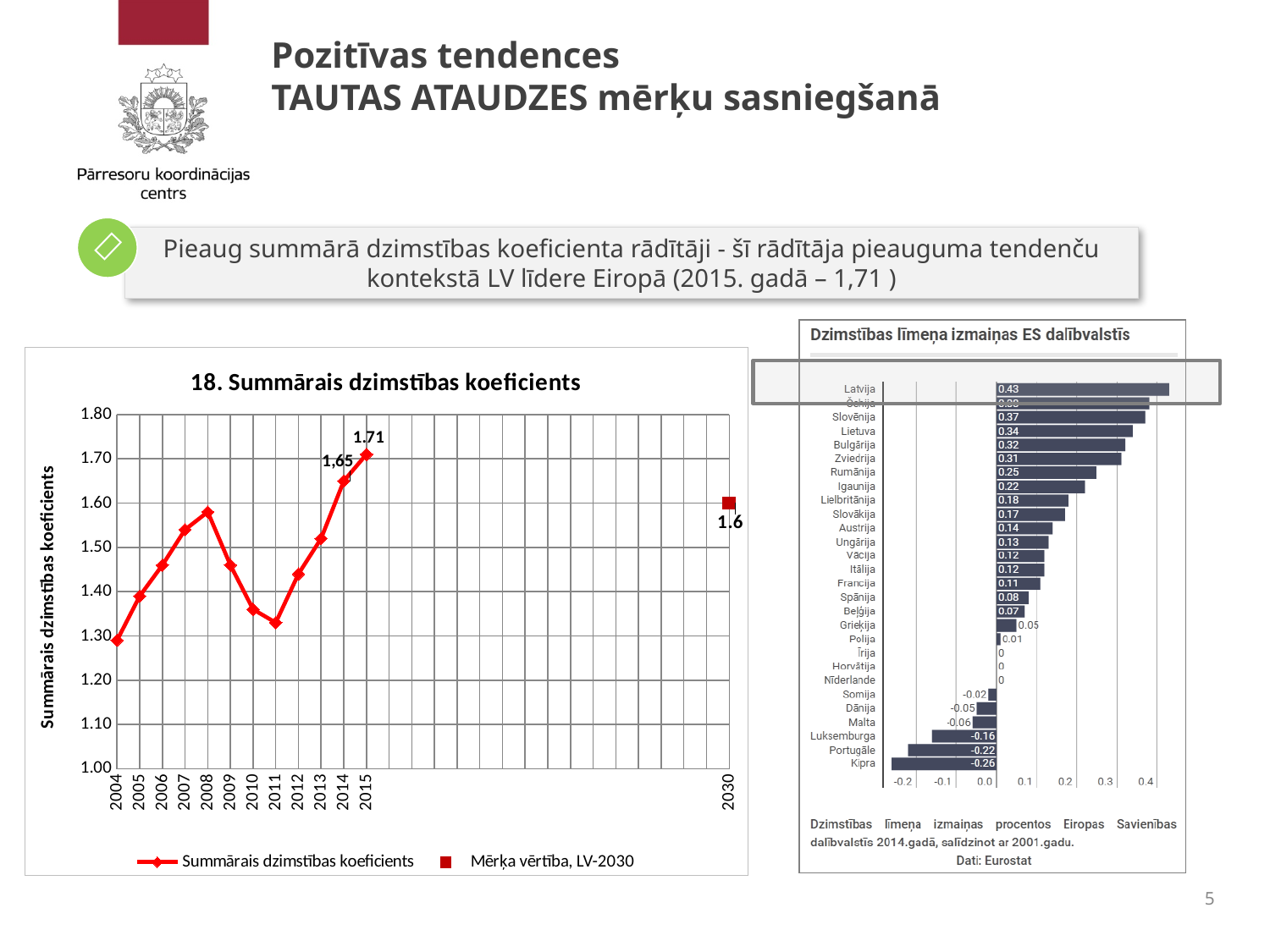
What kind of chart is '18. Summārais dzimstības koeficients'? line chart In the chart 'Dzimstības līmeņa izmaiņas ES dalībvalstīs', which country has the highest value? Latvija In the chart 'Dzimstības līmeņa izmaiņas ES dalībvalstīs', what is the value for Portugāle? -0.22 In the chart '18. Summārais dzimstības koeficients', is the value for 2011 greater or less than 1.40? less In the chart 'Dzimstības līmeņa izmaiņas ES dalībvalstīs', which country has the lowest value? Kipra In the chart '18. Summārais dzimstības koeficients', what is the target value (Mērķa vērtība, LV-2030) shown for 2030? 1.6 In the chart '18. Summārais dzimstības koeficients', what is the difference between the 2015 value and the 2014 value? 0.06 In the chart '18. Summārais dzimstības koeficients', what is the value for 2014? 1.65 In the chart '18. Summārais dzimstības koeficients', how many series does the legend list? 2 In the chart 'Dzimstības līmeņa izmaiņas ES dalībvalstīs', what is the value for Lietuva? 0.34 In the chart '18. Summārais dzimstības koeficients', what is the value for 2015? 1.71 In the chart 'Dzimstības līmeņa izmaiņas ES dalībvalstīs', which has the larger value, Rumānija or Igaunija? Rumānija